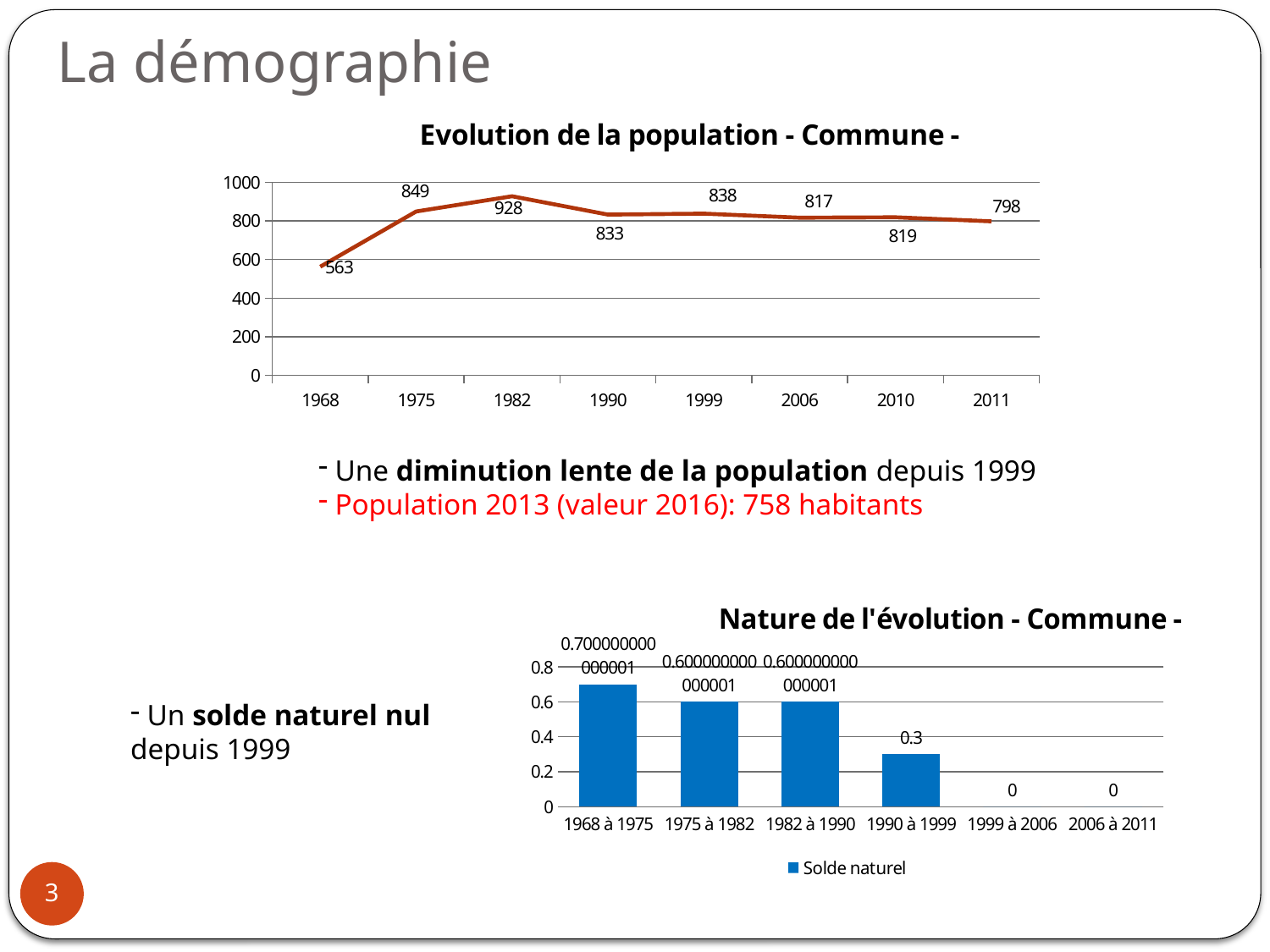
In the chart 'Evolution de la population - Commune -', is the population higher in 1975 or in 2006? 1975 In the chart 'Evolution de la population - Commune -', which year has the lowest population? 1968 In the chart 'Nature de l'évolution - Commune -', what is the value for '2006 à 2011'? 0 In the chart 'Nature de l'évolution - Commune -', what is the value for '1990 à 1999'? 0.3 In the chart 'Evolution de la population - Commune -', how many years are plotted on the x axis? 8 What type of chart is 'Nature de l'évolution - Commune -'? bar chart In the chart 'Evolution de la population - Commune -', what was the population in 1982? 928 In the chart 'Evolution de la population - Commune -', what is the difference between the population in 1982 and in 2011? 130 In the chart 'Evolution de la population - Commune -', does the population rise or fall between 1999 and 2011? fall In the chart 'Evolution de la population - Commune -', which year has the highest population? 1982 In the chart 'Evolution de la population - Commune -', what was the population in 1968? 563 What type of chart is 'Evolution de la population - Commune -'? line chart